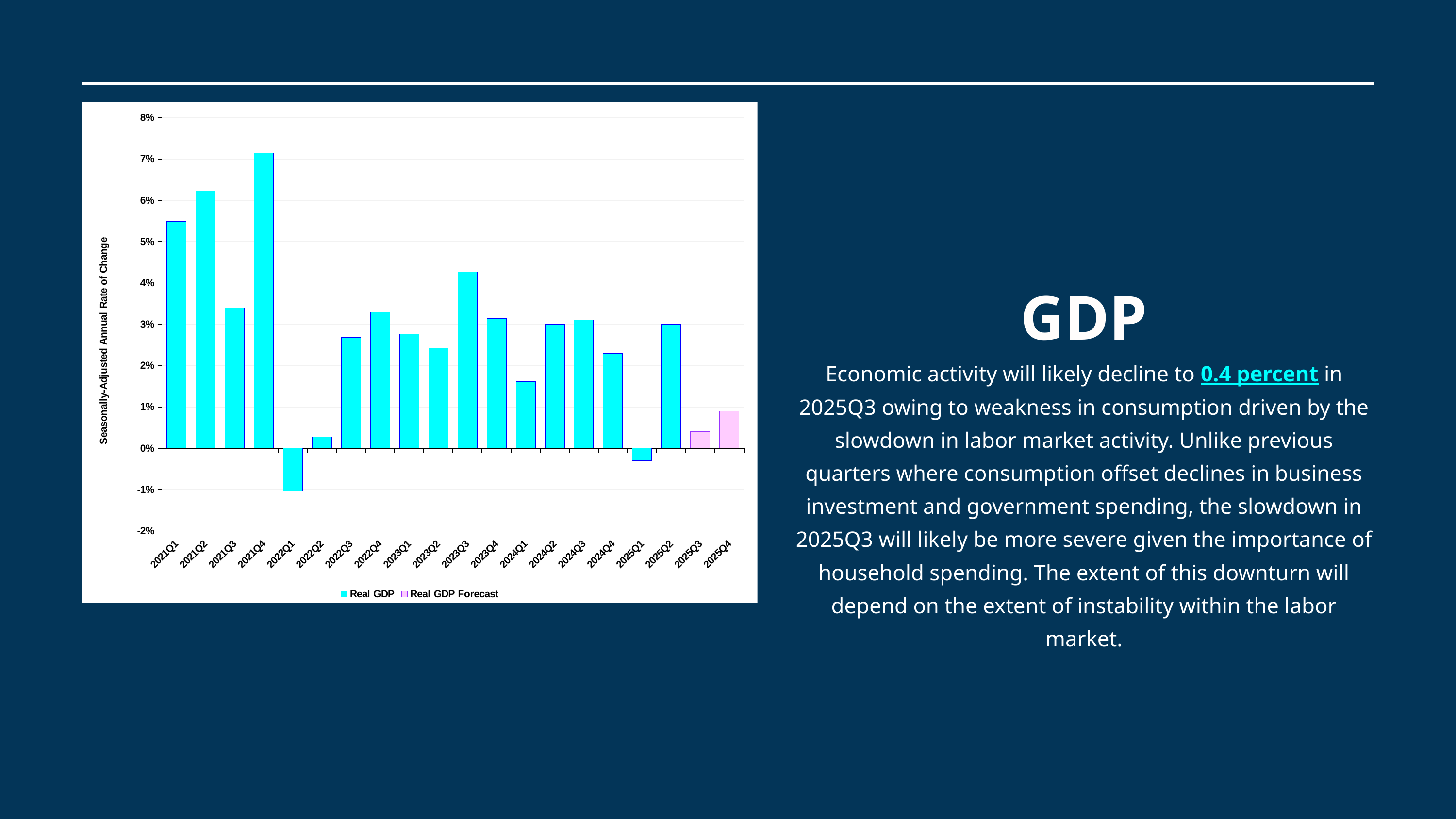
What are the two series named in the chart's legend? Real GDP and Real GDP Forecast Which quarter has the highest value in the chart? 2021Q4 Is the value for 2023Q3 greater or less than 4%? greater Is the value for 2021Q4 greater or less than 7%? greater What kind of chart is shown on the slide? bar chart How many series does the chart's legend list? 2 Is the value for 2025Q3 greater or less than 1%? less Which quarter has the lowest value in the chart? 2022Q1 How many quarters are shown along the x axis of the chart? 20 What is the label on the chart's vertical axis? Seasonally-Adjusted Annual Rate of Change Which is larger, the value for 2021Q2 or the value for 2021Q3? 2021Q2